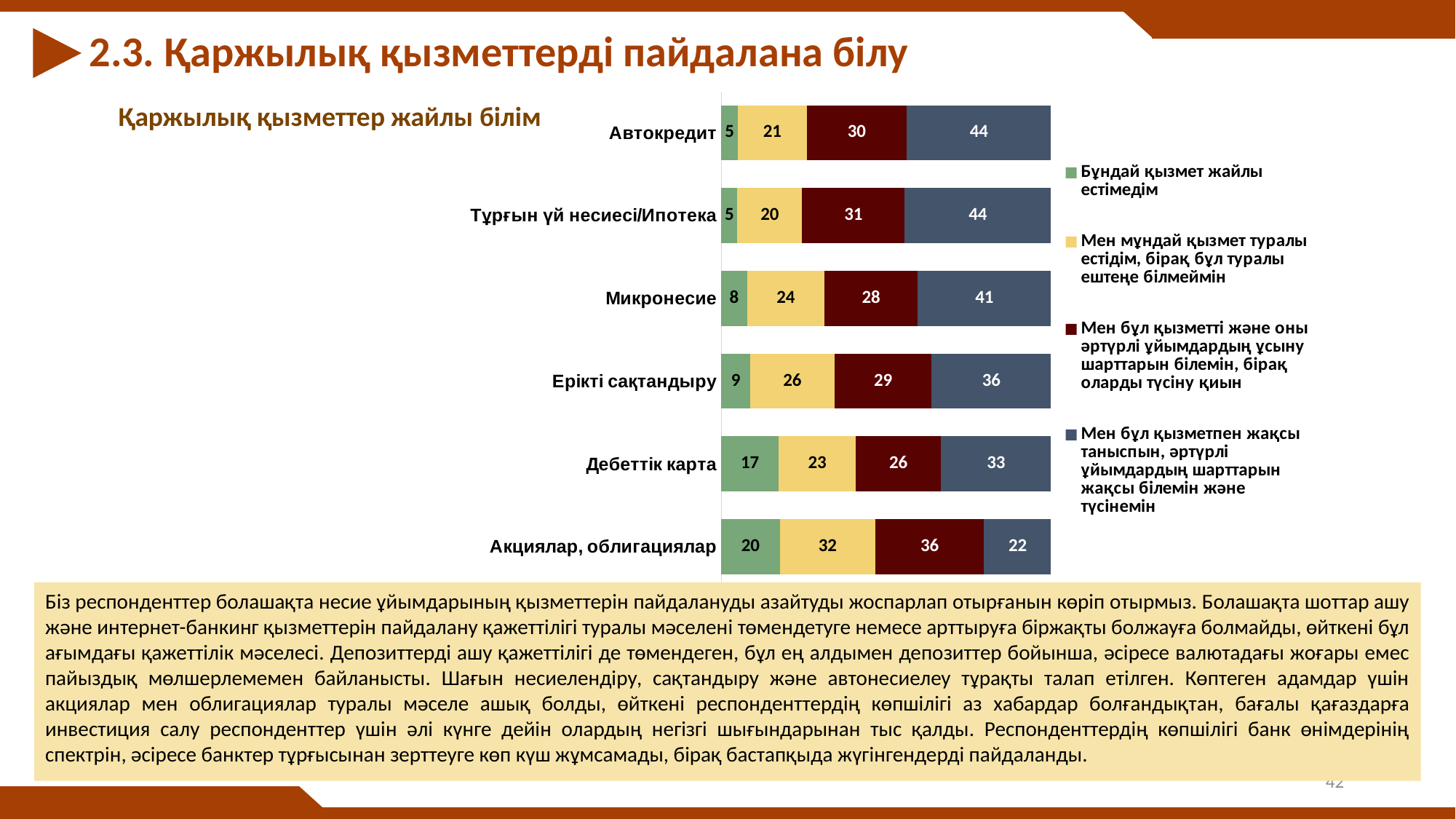
What is the difference between the 'Мен бұл қызметті және оны әртүрлі ұйымдардың ұсыну шарттарын білемін, бірақ оларды түсіну қиын' values for 'Акциялар, облигациялар' and 'Дебеттік карта'? 10 Which is larger: the 'Бұндай қызмет жайлы естімедім' value for 'Дебеттік карта' or for 'Микронесие'? Дебеттік карта What is the value of the 'Бұндай қызмет жайлы естімедім' series for 'Акциялар, облигациялар'? 20 What is the value of the 'Мен мұндай қызмет туралы естідім, бірақ бұл туралы ештеңе білмеймін' series for 'Ерікті сақтандыру'? 26 How many categories are plotted in the chart? 6 Which category has the highest value for the 'Бұндай қызмет жайлы естімедім' series? Акциялар, облигациялар What kind of chart is shown on the slide? Stacked bar chart What is the value of the 'Мен бұл қызметпен жақсы таныспын, әртүрлі ұйымдардың шарттарын жақсы білемін және түсінемін' series for 'Автокредит'? 44 Which category has the lowest value for the 'Мен бұл қызметпен жақсы таныспын, әртүрлі ұйымдардың шарттарын жақсы білемін және түсінемін' series? Акциялар, облигациялар What is the title of the chart? Қаржылық қызметтер жайлы білім How many series does the legend list? 4 What is the total of the stacked bar for 'Микронесие'? 101